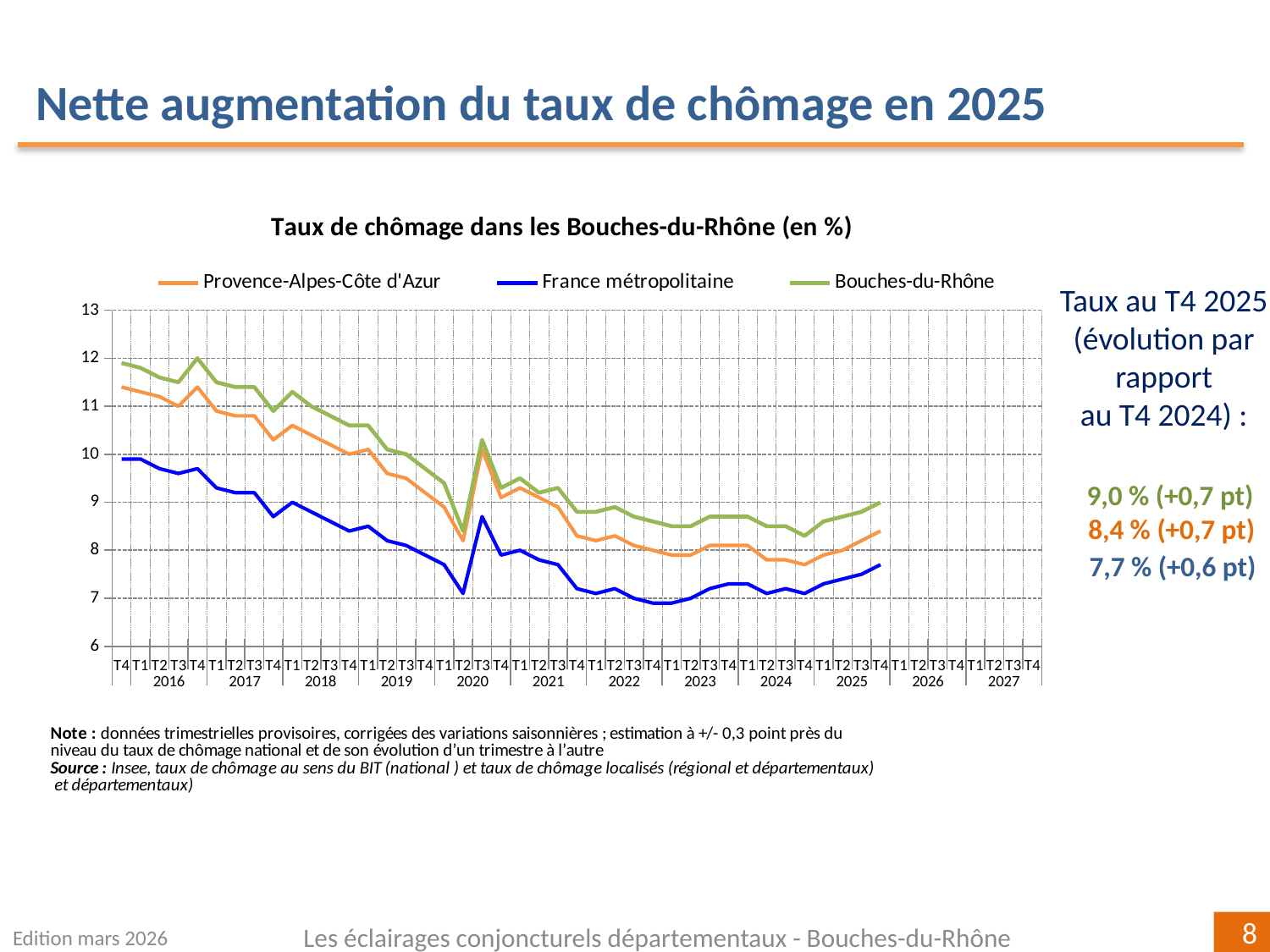
What is the unemployment rate for Provence-Alpes-Côte d'Azur at T4 2025? 8,4 % How many series does the chart legend list? 3 What is the unemployment rate for France métropolitaine at T4 2025? 7,7 % Is the value for France métropolitaine at T2 2020 greater or less than 8? less Which series has the lowest value at T4 2025? France métropolitaine What is the unemployment rate for Bouches-du-Rhône at T4 2025? 9,0 % Is the value for Bouches-du-Rhône at T4 2016 greater or less than 11? greater What type of chart is shown on the slide? Line chart Which series has the highest value at T4 2025? Bouches-du-Rhône What is the title of the chart? Taux de chômage dans les Bouches-du-Rhône (en %) What is the difference between the Bouches-du-Rhône and France métropolitaine rates at T4 2025? 1,3 points Which colour is used for the France métropolitaine line? Blue